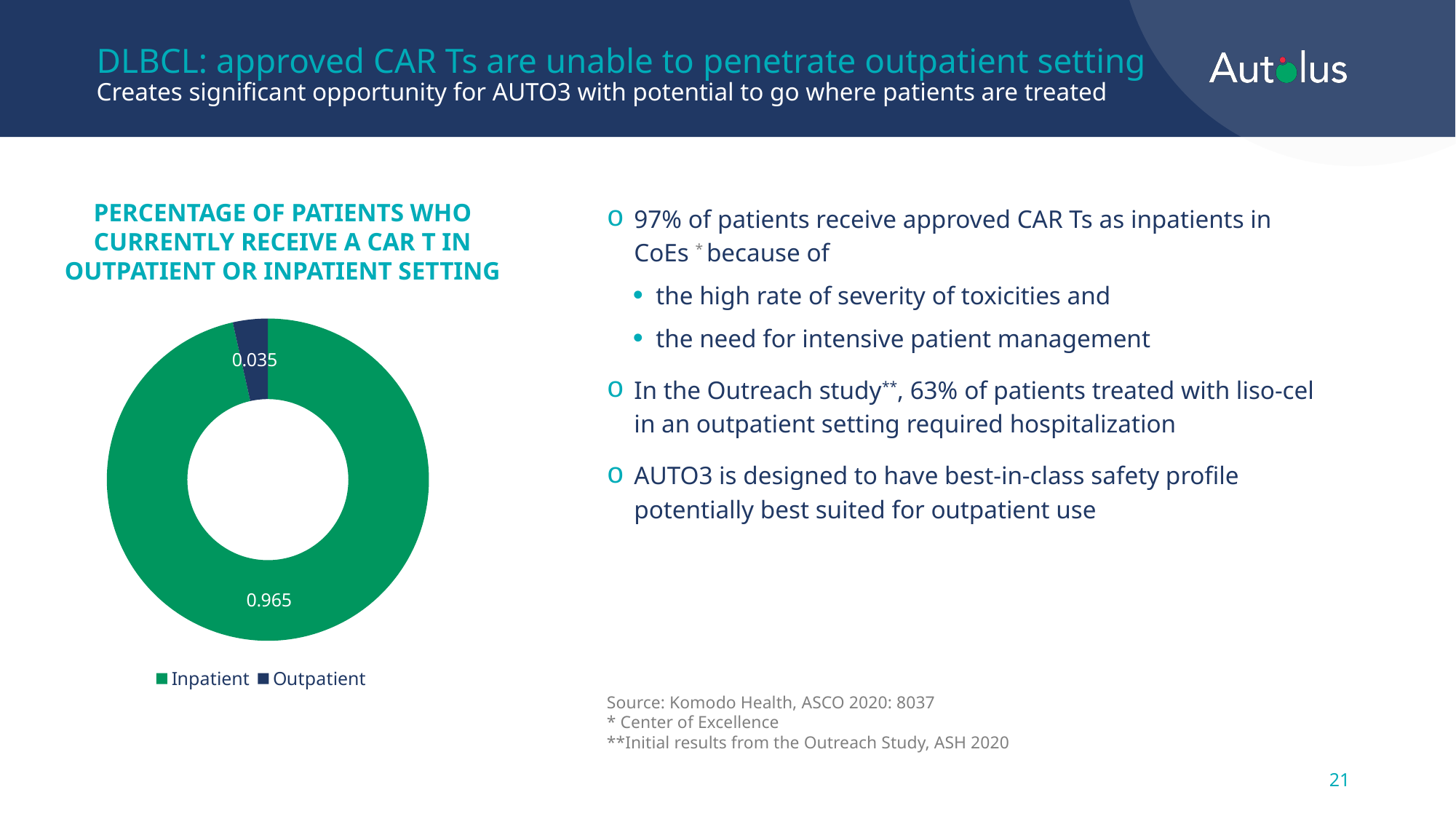
How many categories are shown in the doughnut chart? 2 Which is larger in the doughnut chart, Inpatient or Outpatient? Inpatient What is the difference between the Inpatient and Outpatient values in the doughnut chart? 0.93 Which category has the largest slice in the doughnut chart? Inpatient Which category has the smallest slice in the doughnut chart? Outpatient What is the value shown for Outpatient in the doughnut chart? 0.035 What share of the doughnut chart does the Outpatient slice represent? 0.035 What colour represents Inpatient in the doughnut chart? Green What is the title of the chart on the slide? PERCENTAGE OF PATIENTS WHO CURRENTLY RECEIVE A CAR T IN OUTPATIENT OR INPATIENT SETTING What is the value shown for Inpatient in the doughnut chart? 0.965 What kind of chart is shown on the slide? Doughnut (pie) chart How many entries does the legend of the doughnut chart list? 2